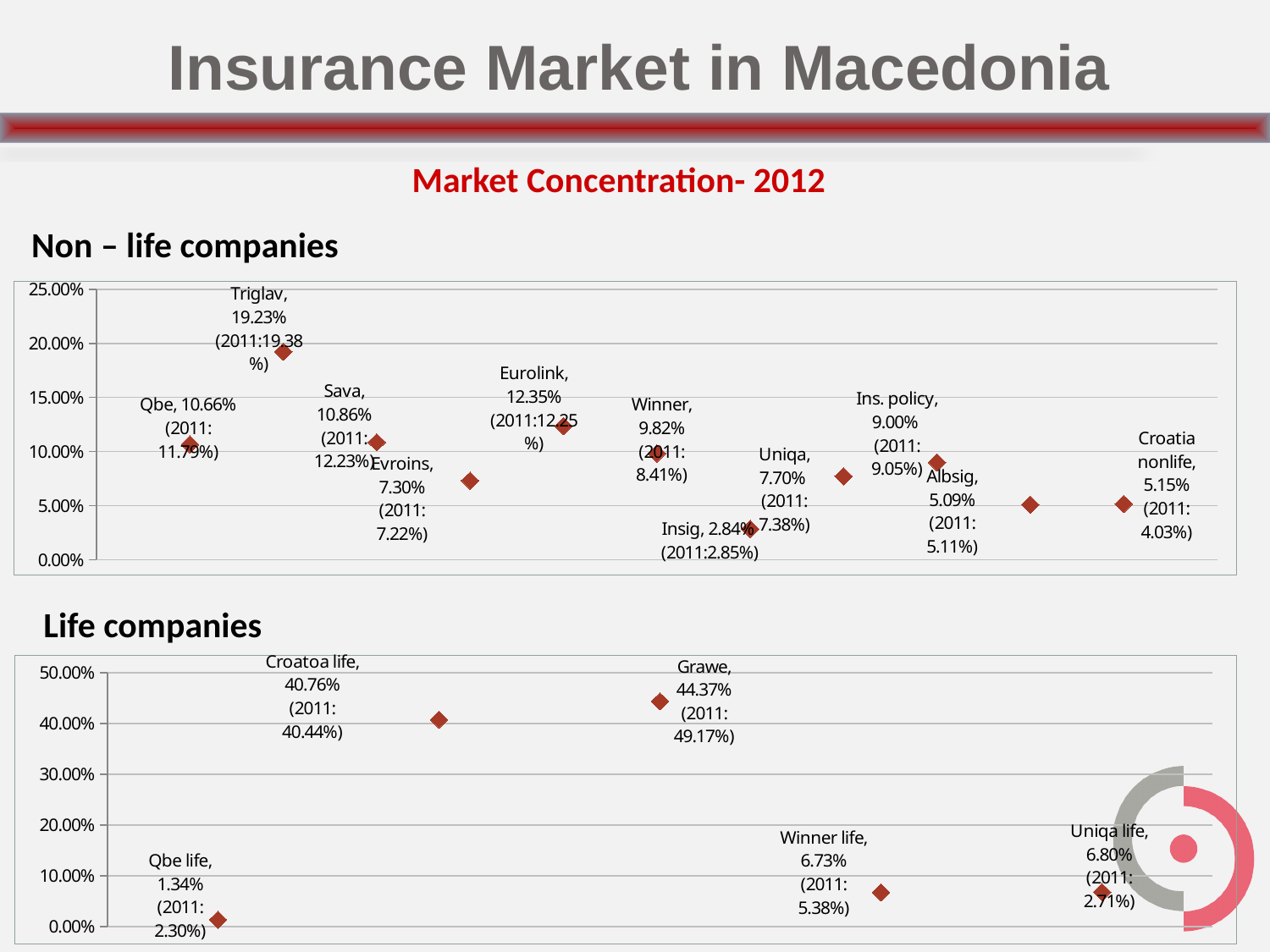
In the Non-life companies chart, what is the 2012 market share of Triglav? 19.23% In the Life companies chart, what was Uniqa life's market share in 2011? 2.71% In the Non-life companies chart, what was Winner's market share in 2011? 8.41% In the Non-life companies chart, which company has the lowest 2012 market share? Insig What kind of chart is the Life companies chart? Scatter chart In the Non-life companies chart, what is the difference between Triglav's and Sava's 2012 market shares? 8.37% In the Non-life companies chart, which company has the highest 2012 market share? Triglav In the Life companies chart, which company has the lowest 2012 market share? Qbe life In the Non-life companies chart, how many companies are plotted? 11 In the Life companies chart, how many companies are plotted? 5 In the Life companies chart, what is the 2012 market share of Grawe? 44.37% In the Non-life companies chart, what is the 2012 market share of Eurolink? 12.35%